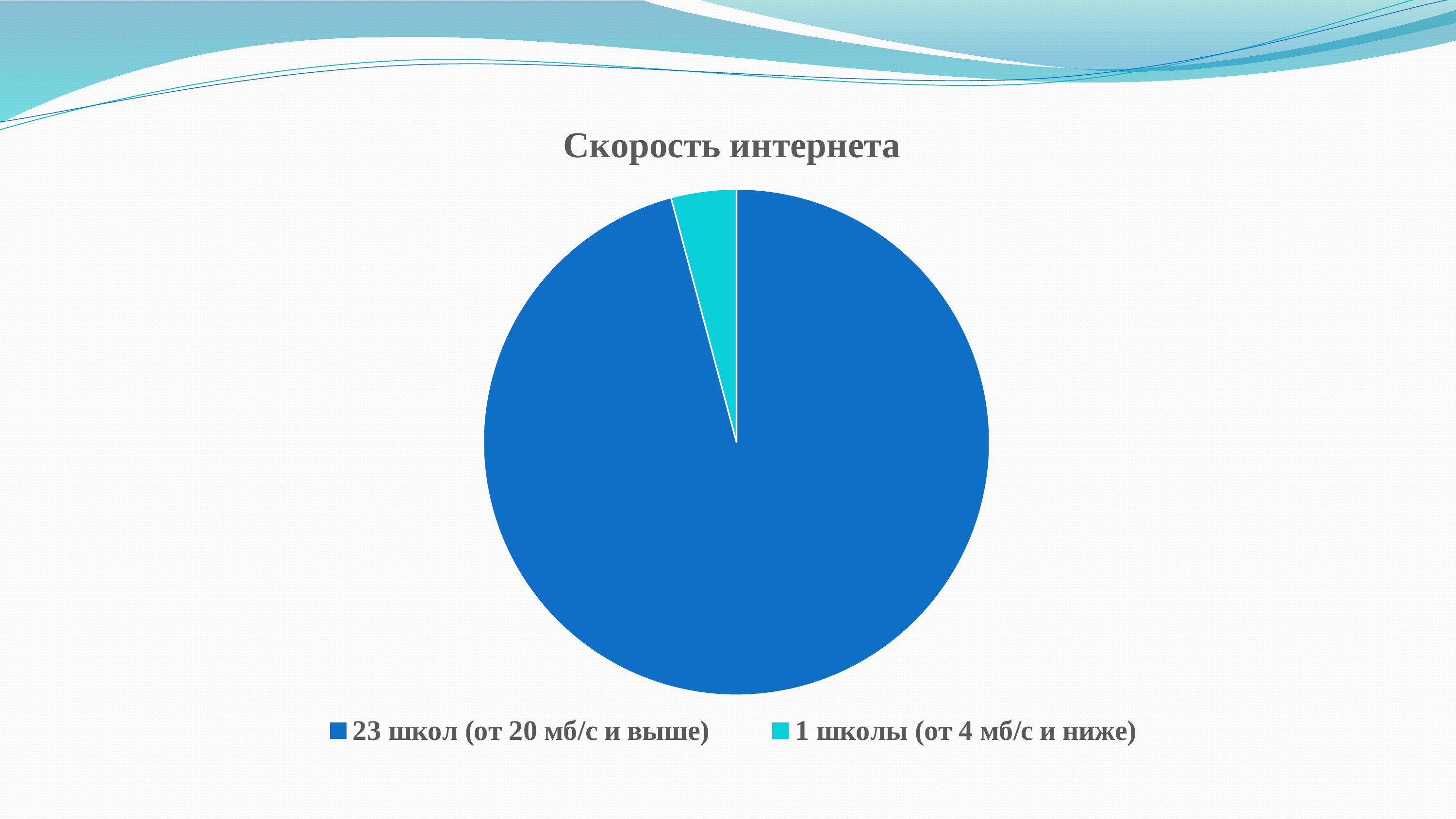
According to the legend, how many schools have internet speed of 20 мб/с and above? 23 Is the slice for '23 школ (от 20 мб/с и выше)' more or less than half of the pie? more According to the legend, how many schools have internet speed of 4 мб/с and below? 1 Which is larger: the slice for schools with 20 мб/с and above, or the slice for schools with 4 мб/с and below? 23 школ (от 20 мб/с и выше) What kind of chart is shown on the slide? pie chart What is the title of the chart? Скорость интернета How many slices does the pie chart have? 2 Which slice of the pie chart is the smallest? 1 школы (от 4 мб/с и ниже) What colour is the slice for '1 школы (от 4 мб/с и ниже)'? cyan What is the difference between the number of schools with 20 мб/с and above and the number with 4 мб/с and below? 22 How many entries does the legend list? 2 Which slice of the pie chart is the largest? 23 школ (от 20 мб/с и выше)